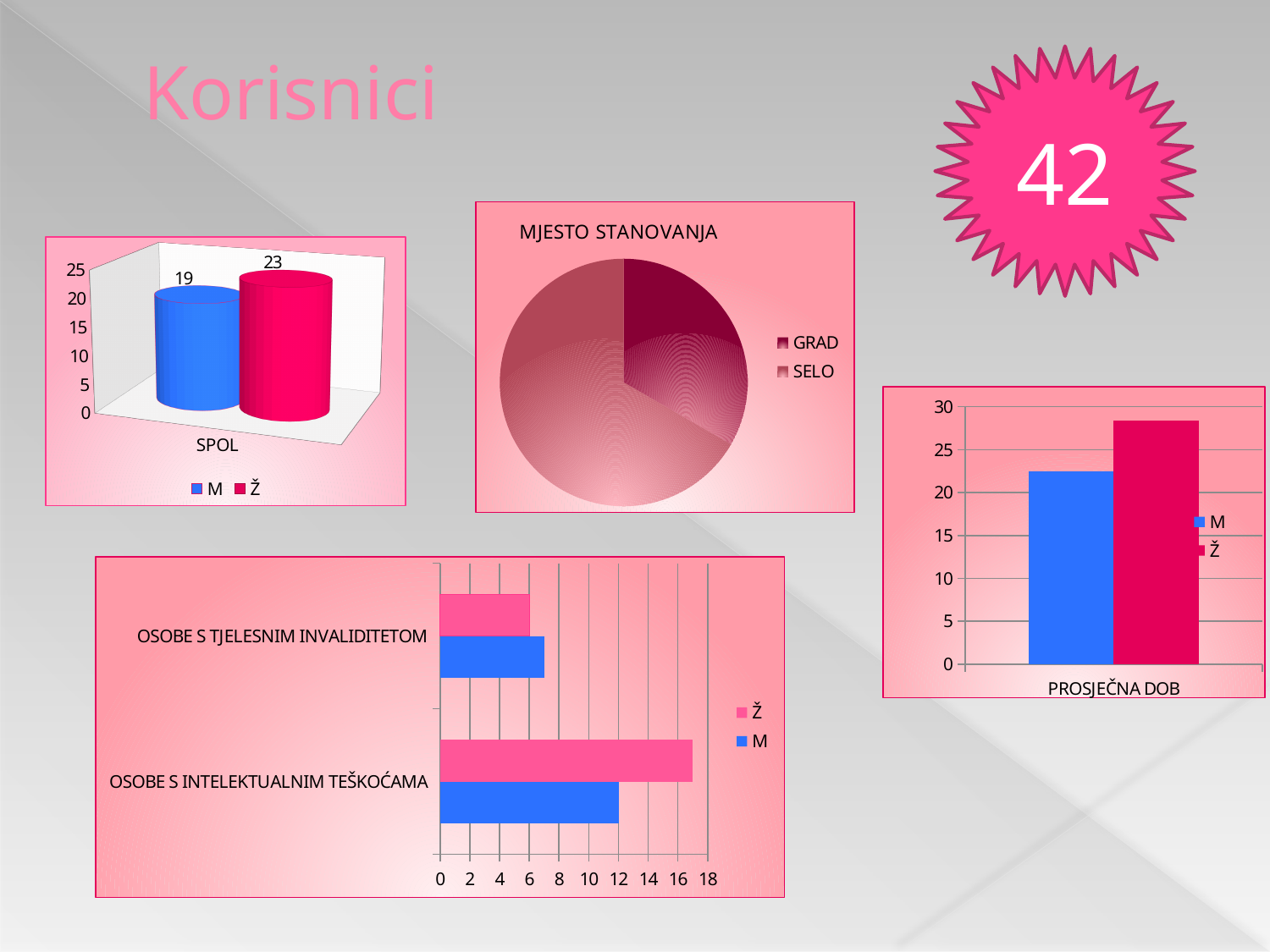
In the SPOL chart, what is the difference between the values for Ž and M? 4 In the MJESTO STANOVANJA pie chart, which slice is larger, GRAD or SELO? SELO In the SPOL chart, which series has the higher value, M or Ž? Ž In the bottom-left horizontal bar chart, which category has the higher value for M? OSOBE S INTELEKTUALNIM TEŠKOĆAMA In the PROSJEČNA DOB chart, is the value for Ž greater or less than 25? greater How many categories does the bottom-left horizontal bar chart show? 2 What kind of chart is the MJESTO STANOVANJA chart? pie chart How many series does the legend of the MJESTO STANOVANJA chart list? 2 In the SPOL chart, what is the value for Ž? 23 In the PROSJEČNA DOB chart, is the value for M greater or less than 25? less In the bottom-left horizontal bar chart, is the value for Ž in OSOBE S INTELEKTUALNIM TEŠKOĆAMA greater or less than 16? greater In the SPOL chart, what is the value for M? 19